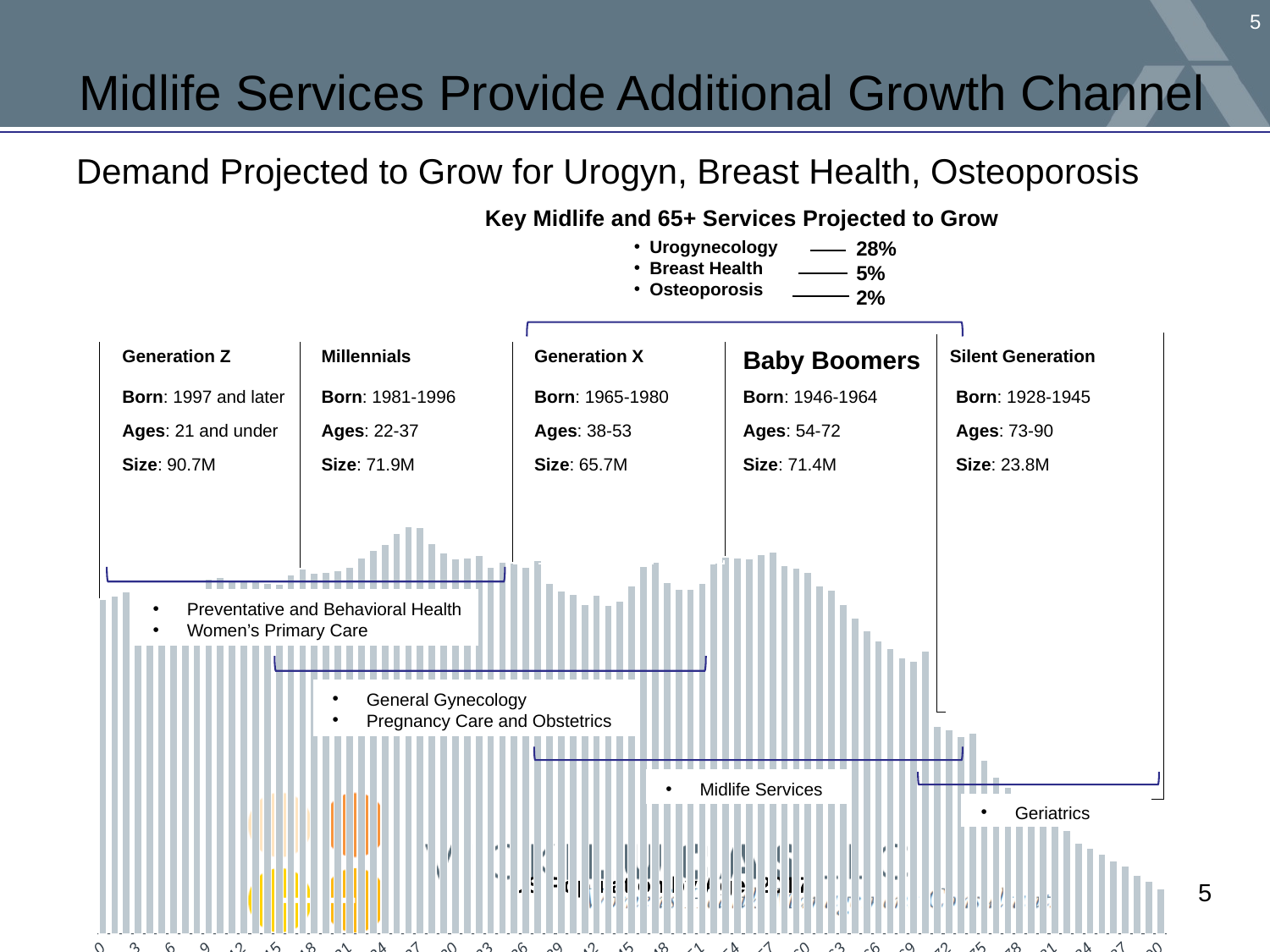
What size is printed for the Silent Generation on the chart? 23.8M Which age has the shortest bar in the chart? 90 What age range is printed for Generation X on the chart? 38-53 What size is printed for Generation Z on the chart? 90.7M Do the bars rise or fall along the x axis from age 60 to age 90? fall What size is printed for Baby Boomers on the chart? 71.4M Which is taller, the bar at age 24 or the bar at age 84? age 24 How many generation groups are labeled across the top of the chart? 5 What kind of chart is shown on the slide? bar chart What growth percentage is shown for Osteoporosis? 2% What growth percentage is shown for Urogynecology? 28% Which is taller, the bar at age 57 or the bar at age 75? age 57